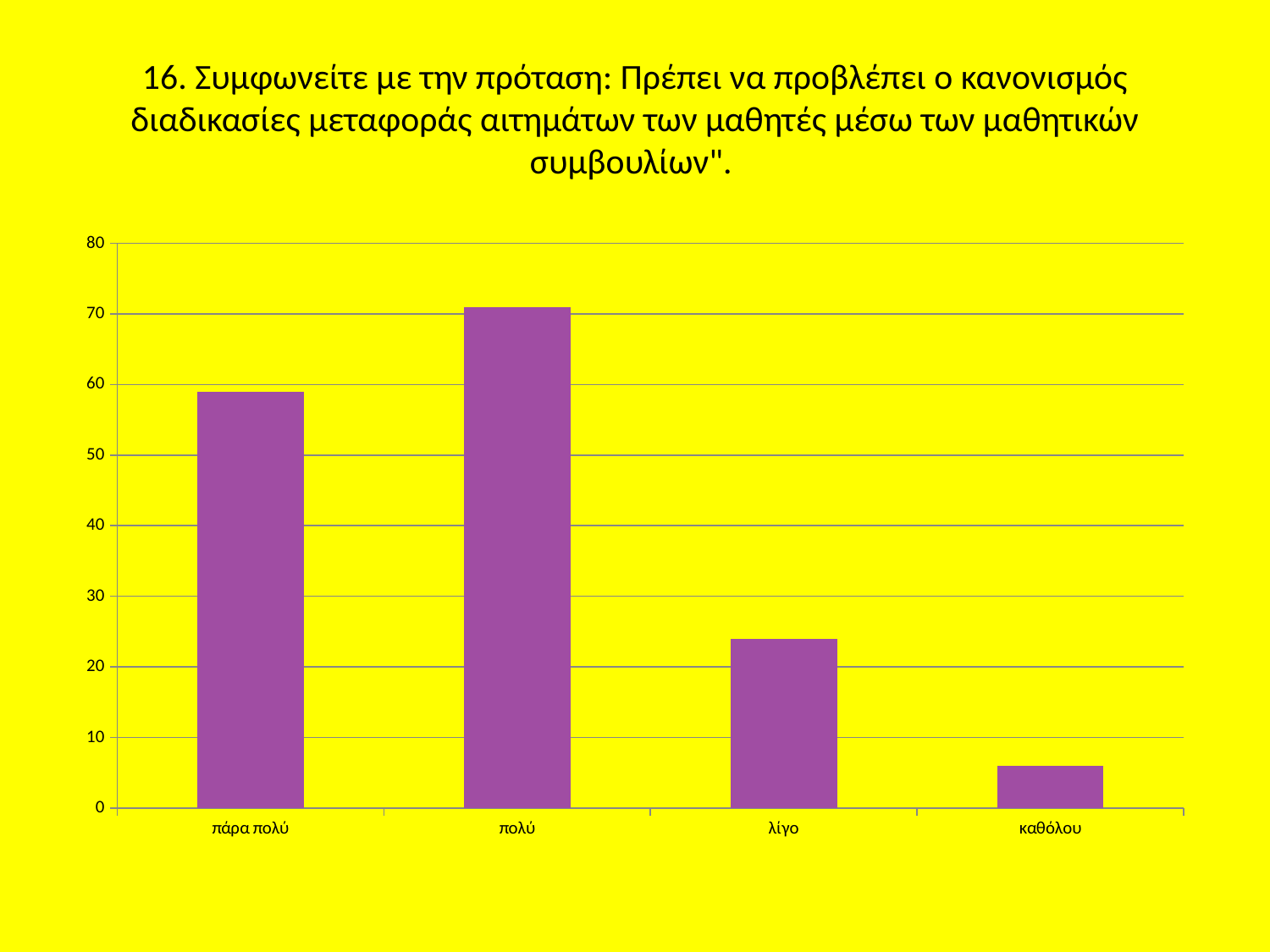
Is the value for λίγο greater or less than 30? less Is the value for πολύ greater or less than 60? greater Is the value for καθόλου greater or less than 10? less Which category has the lowest bar in the chart? καθόλου Which is larger, the value for πάρα πολύ or the value for λίγο? πάρα πολύ Which is larger, the value for πολύ or the value for πάρα πολύ? πολύ What colour are the bars in the chart? purple What kind of chart is shown on the slide? bar chart Which category has the highest bar in the chart? πολύ How many categories are shown on the x axis of the chart? 4